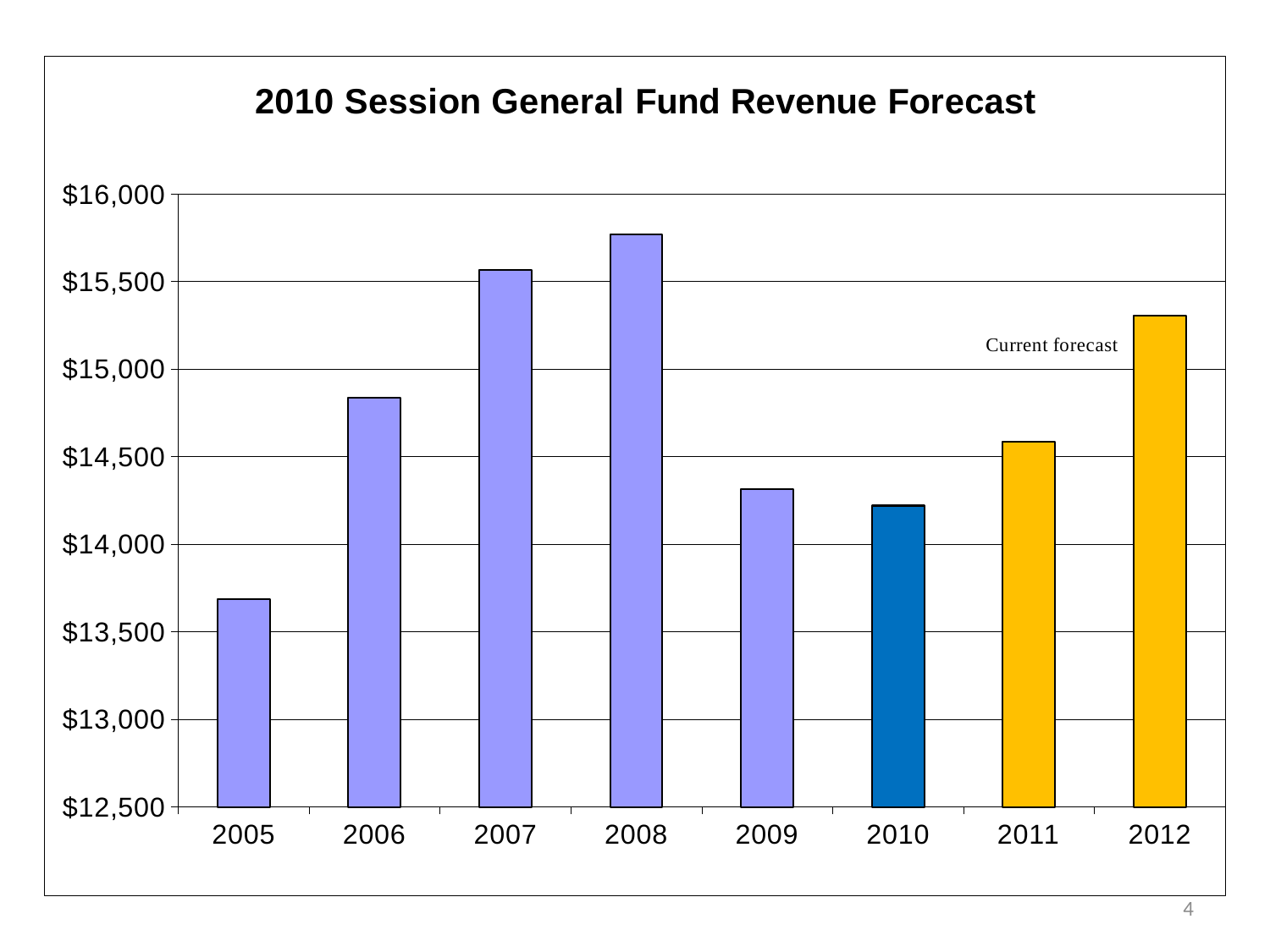
Is the value for 2008 greater or less than $15,500? greater How many years are shown on the x axis of the chart? 8 Which year has the larger value, 2007 or 2008? 2008 Which years are labelled as the current forecast (shown in yellow bars)? 2011 and 2012 What is the title of the chart? 2010 Session General Fund Revenue Forecast Do the values rise or fall from 2005 to 2008? Rise Which year has the lowest general fund revenue in the chart? 2005 Is the value for 2005 greater or less than $14,000? less Which year has the highest general fund revenue in the chart? 2008 Is the value for 2006 greater or less than $15,000? less What type of chart is shown on the slide? Bar chart